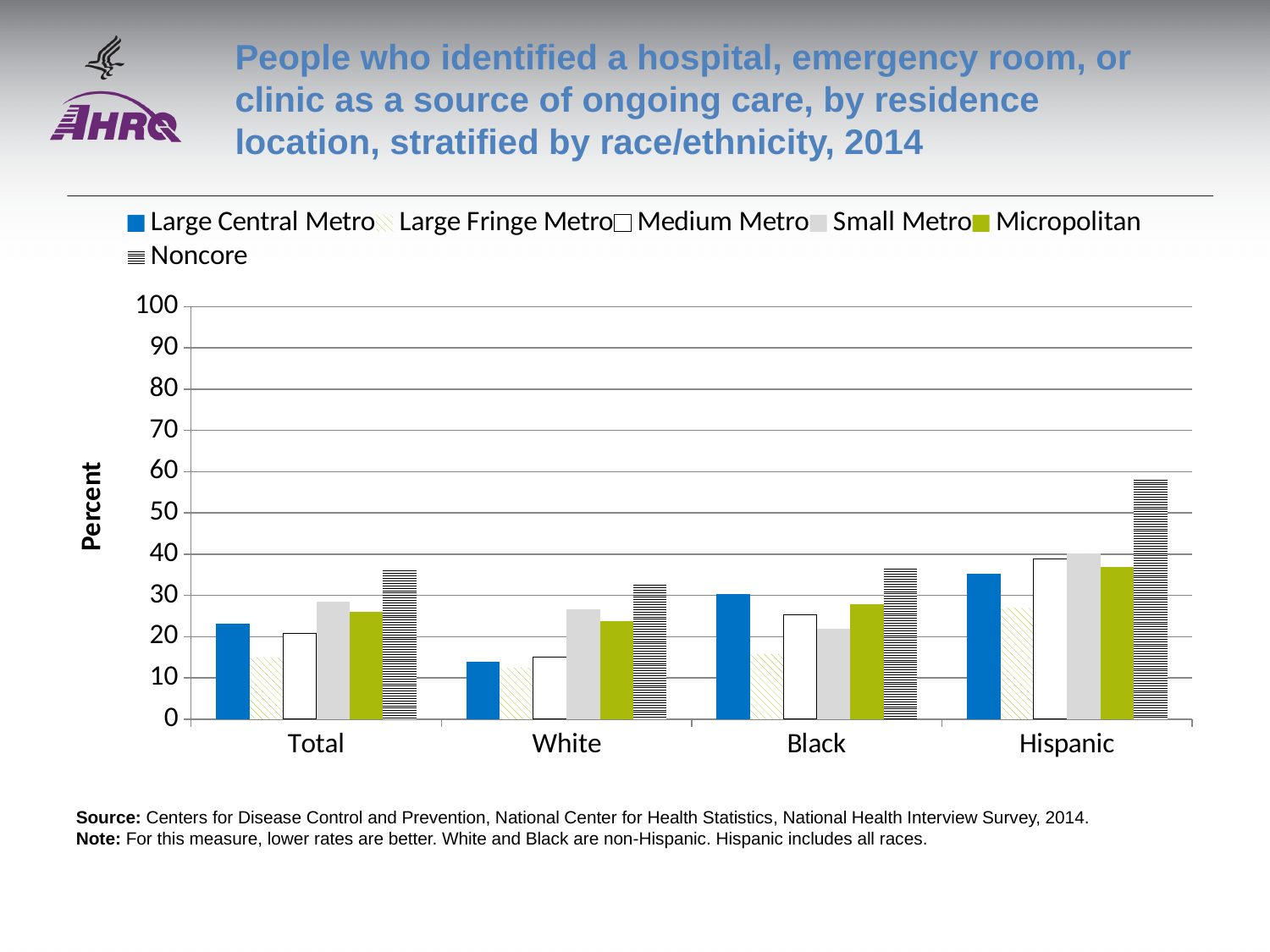
Is the Noncore value for Hispanic greater or less than 50? greater Within the Hispanic group, which residence location has the highest value? Noncore Is the Noncore value for Total greater or less than 30? greater How many race/ethnicity categories are shown on the x axis? 4 Within the White group, which residence location has the lowest value? Large Fringe Metro What is the label on the y axis? Percent For the Black group, which is larger: the Large Central Metro value or the Small Metro value? Large Central Metro Which year does the chart's data refer to? 2014 What kind of chart is shown on the slide? Bar chart How many series does the legend list? 6 For the Total group, which is larger: the Noncore value or the Large Fringe Metro value? Noncore Is the Large Central Metro value for White greater or less than 20? less